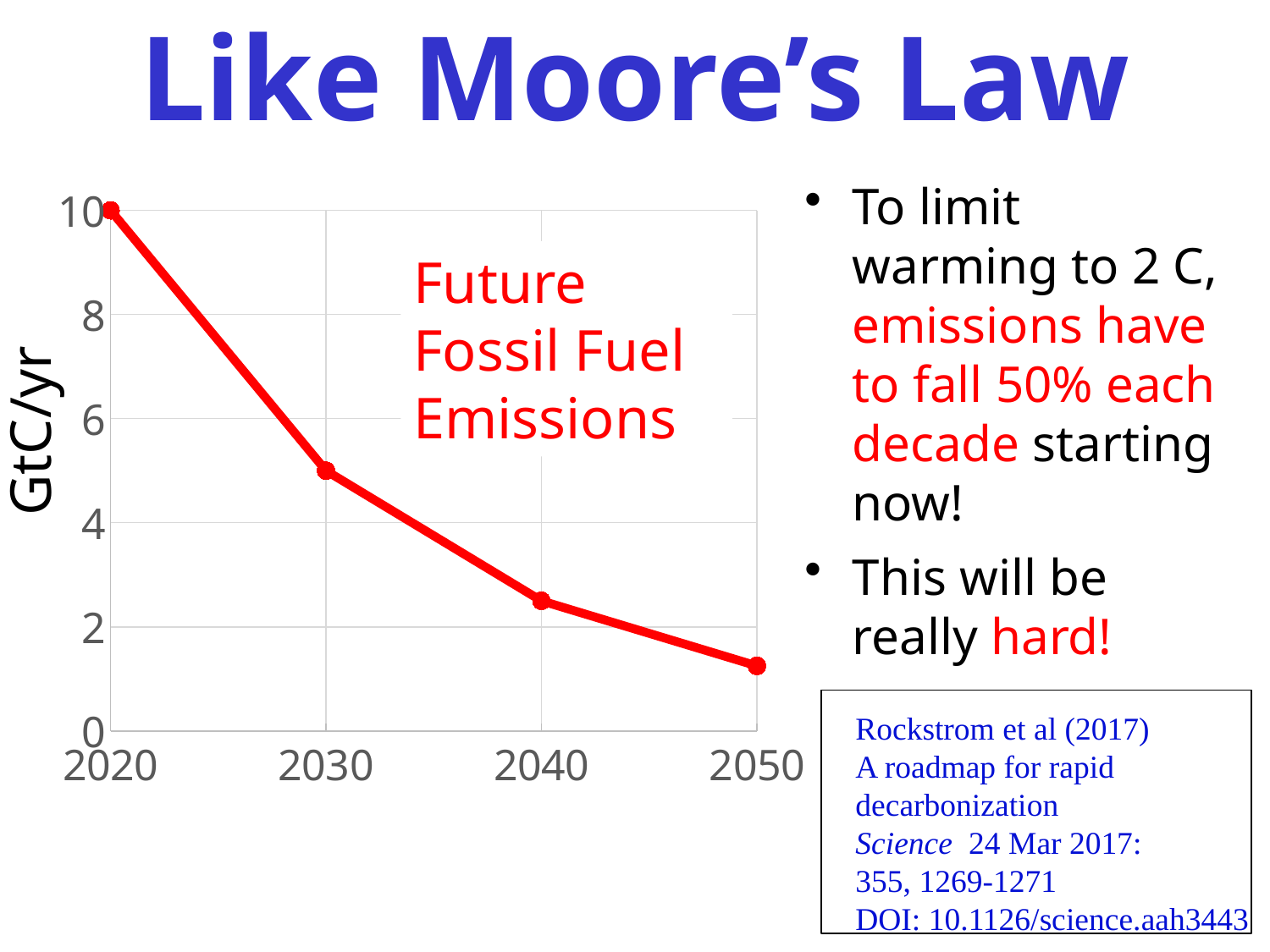
What is the label on the vertical axis of the chart? GtC/yr Which year has the highest plotted value? 2020 What kind of chart is shown on the slide? line chart Is the value for 2050 greater or less than 2? less Which year has the lowest plotted value? 2050 Do the plotted values rise or fall from 2020 to 2050? fall Is the value for 2030 greater or less than 6? less Is the value for 2030 greater or less than 4? greater What is the value plotted for 2020? 10 Which year has the larger plotted value, 2030 or 2040? 2030 How many data points are plotted on the line? 4